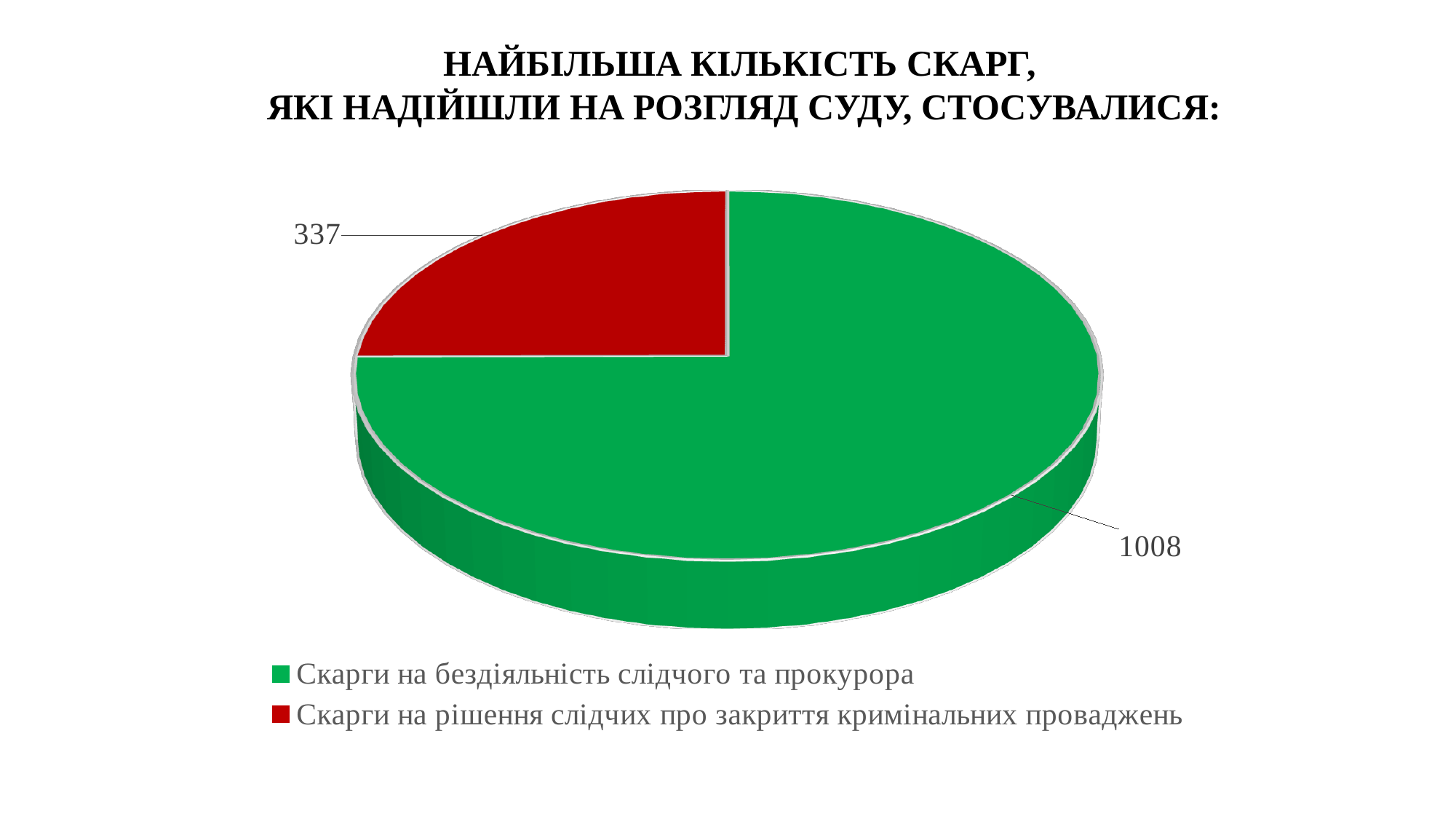
What is the value for 'Скарги на рішення слідчих про закриття кримінальних проваджень'? 337 What is the total of all slices in the pie chart? 1345 What kind of chart is shown on the slide? Pie chart Which category has the smallest slice of the pie? Скарги на рішення слідчих про закриття кримінальних проваджень How many categories does the pie chart show? 2 What is the title of the chart? НАЙБІЛЬША КІЛЬКІСТЬ СКАРГ, ЯКІ НАДІЙШЛИ НА РОЗГЛЯД СУДУ, СТОСУВАЛИСЯ: What share of the pie does 'Скарги на бездіяльність слідчого та прокурора' represent? 74.9% Which category has the largest slice of the pie? Скарги на бездіяльність слідчого та прокурора What is the value for 'Скарги на бездіяльність слідчого та прокурора'? 1008 What colour is the slice for 'Скарги на рішення слідчих про закриття кримінальних проваджень'? Red What is the difference between the value for 'Скарги на бездіяльність слідчого та прокурора' and the value for 'Скарги на рішення слідчих про закриття кримінальних проваджень'? 671 Which is larger: the value for 'Скарги на бездіяльність слідчого та прокурора' or the value for 'Скарги на рішення слідчих про закриття кримінальних проваджень'? Скарги на бездіяльність слідчого та прокурора